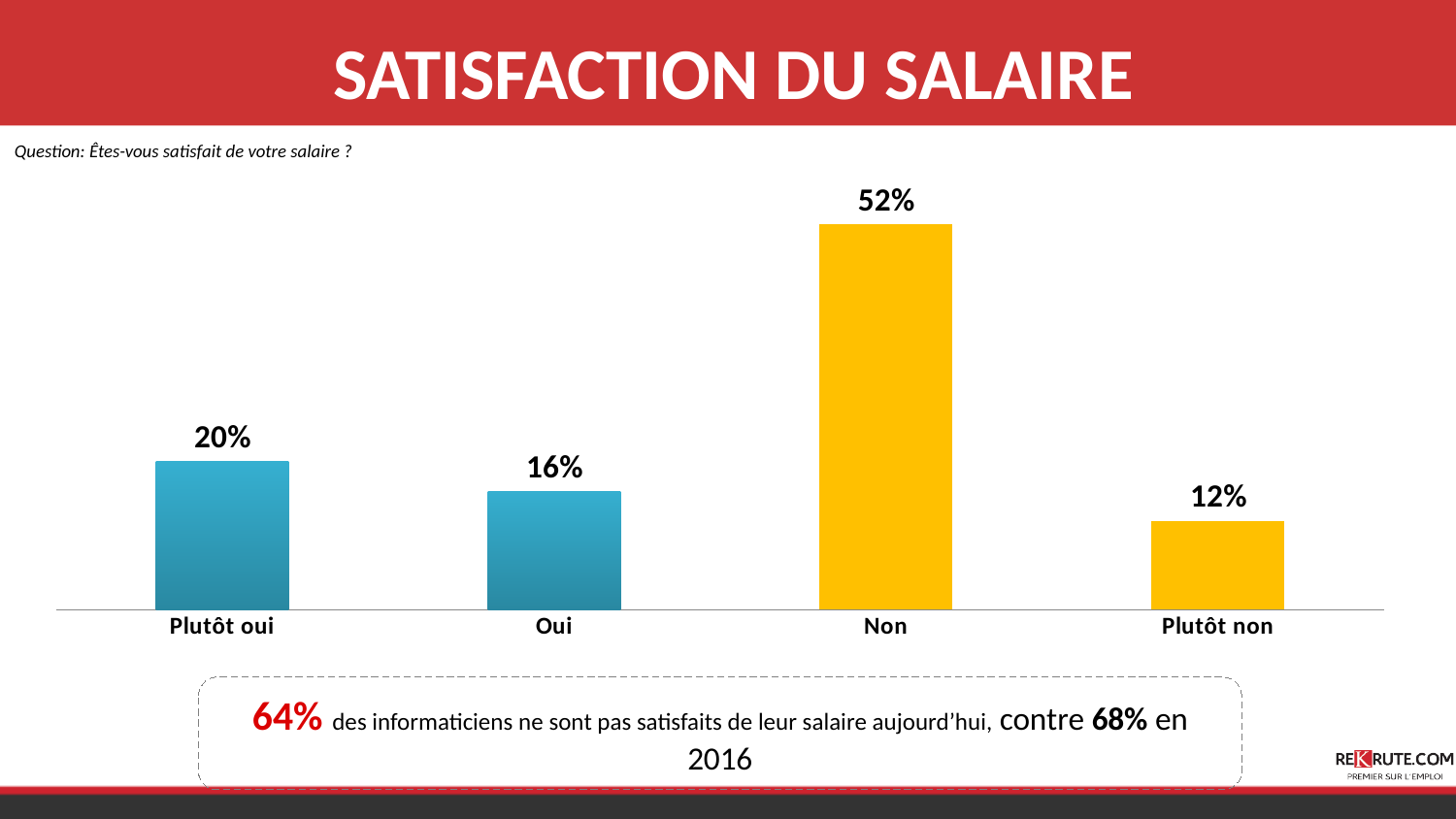
What is the value for "Plutôt oui"? 20% Which category has the highest value? Non What is the difference between the values for "Plutôt oui" and "Oui"? 4% Which is larger, the value for "Plutôt oui" or the value for "Oui"? Plutôt oui What is the difference between the values for "Non" and "Plutôt non"? 40% What kind of chart is shown on the slide? Bar chart What is the value for "Oui"? 16% What colour are the bars for "Non" and "Plutôt non"? Yellow What is the value for "Plutôt non"? 12% What is the value for "Non"? 52% How many categories are shown on the chart? 4 Which category has the lowest value? Plutôt non